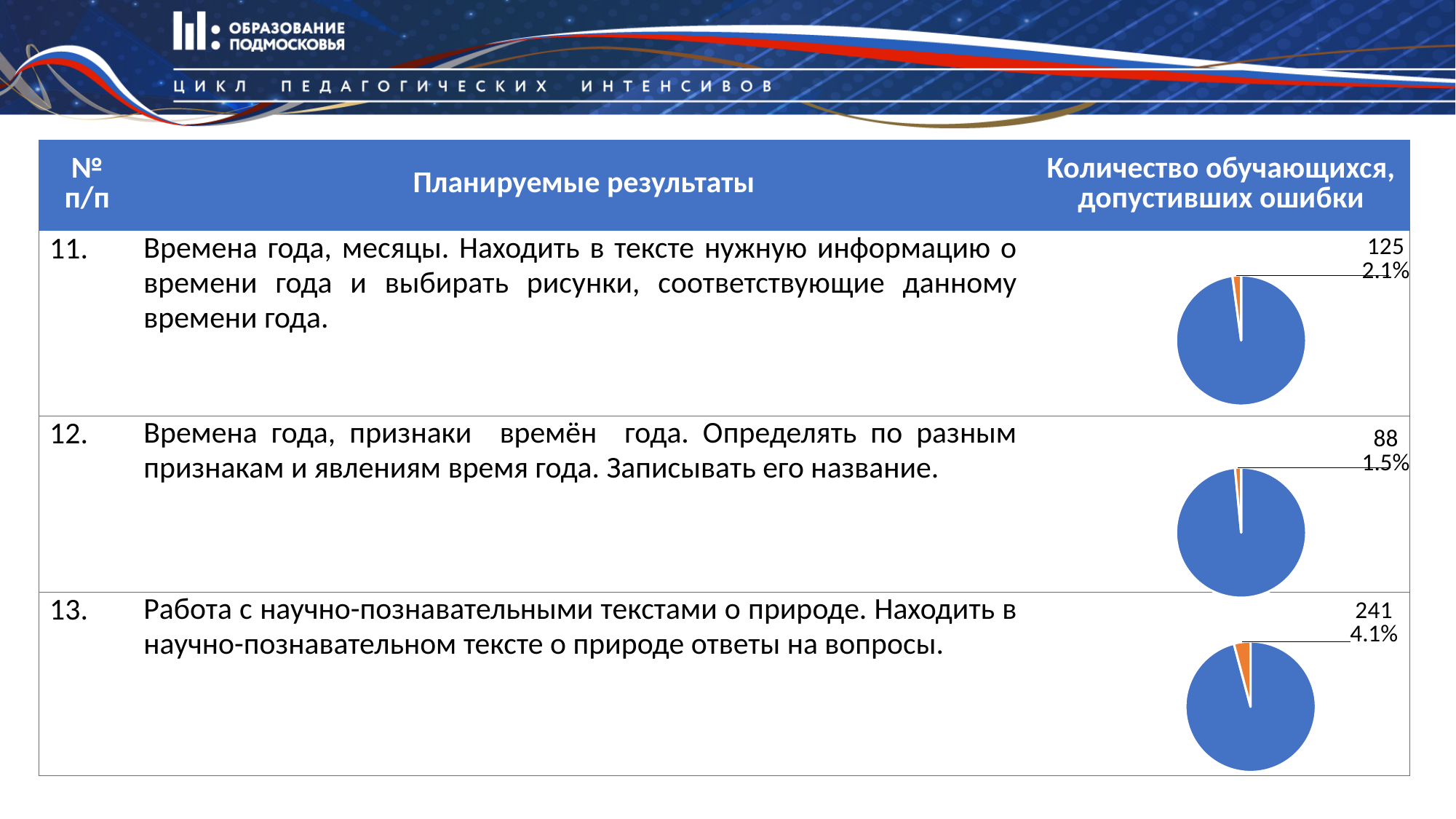
In the pie chart for row 11, what number is printed on the orange slice's label? 125 What is the difference between the labelled count in the row 13 pie chart and the labelled count in the row 11 pie chart? 116 What kind of chart is shown in row 11 of the table? pie chart How many pie charts are shown on the slide? 3 In the pie chart for row 13, what number is printed on the orange slice's label? 241 In the pie chart for row 13, what percentage is shown for the orange slice? 4.1% In the pie chart for row 11, what percentage is shown for the orange slice? 2.1% In the pie chart for row 12, what percentage is shown for the orange slice? 1.5% Which row's pie chart has the largest orange slice: row 11, row 12 or row 13? row 13 Is the labelled count in the row 12 pie chart larger or smaller than the labelled count in the row 11 pie chart? smaller In the pie chart for row 12, what number is printed on the orange slice's label? 88 Which row's pie chart has the smallest orange slice: row 11, row 12 or row 13? row 12